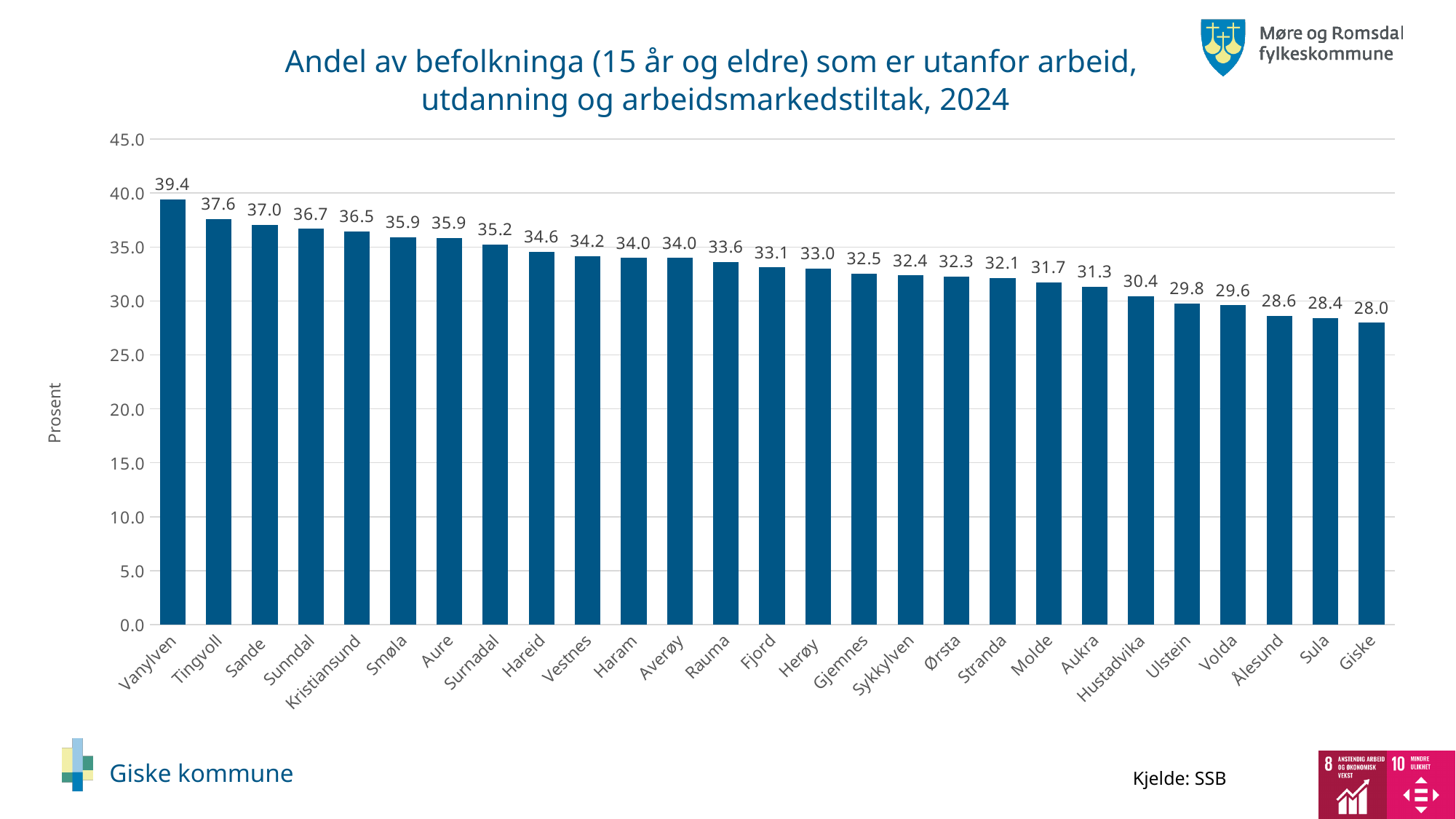
What kind of chart is shown on the slide? Bar chart Which municipality has the lowest value? Giske What is the value for Giske? 28.0 What is the value for Molde? 31.7 What is the difference between the values for Vanylven and Giske? 11.4 Which municipality has the highest value? Vanylven Is the value for Hustadvika greater or less than 35.0? less What is the value for Vanylven? 39.4 What is the label of the vertical axis? Prosent What is the value for Ålesund? 28.6 Which has a larger value, Tingvoll or Sula? Tingvoll How many municipalities are shown in the chart? 27